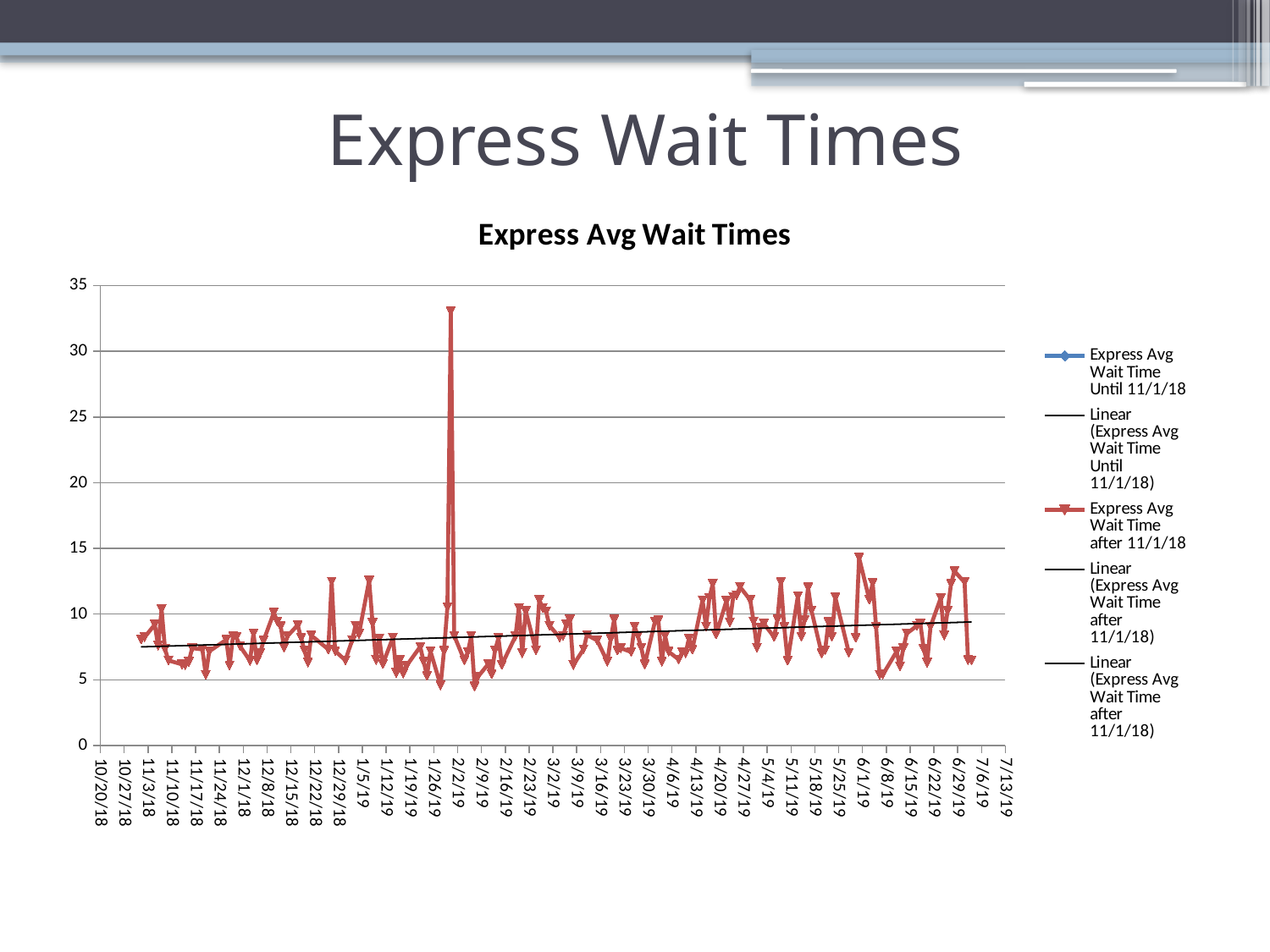
Is the first plotted value of the Express Avg Wait Time after 11/1/18 series (near 10/27/18) greater or less than 5? greater Is the first plotted value of the Express Avg Wait Time after 11/1/18 series (near 10/27/18) greater or less than 10? less What kind of chart is shown on the slide? Line chart Does the linear trend line for Express Avg Wait Time after 11/1/18 rise or fall from left to right? rises Is the value of the Express Avg Wait Time after 11/1/18 series near 6/8/19 greater or less than 10? less What is the highest value shown on the vertical axis? 35 How many entries does the chart legend list? 5 Near which x-axis date does the Express Avg Wait Time after 11/1/18 series reach its highest value? 2/2/19 What is the title of the chart? Express Avg Wait Times